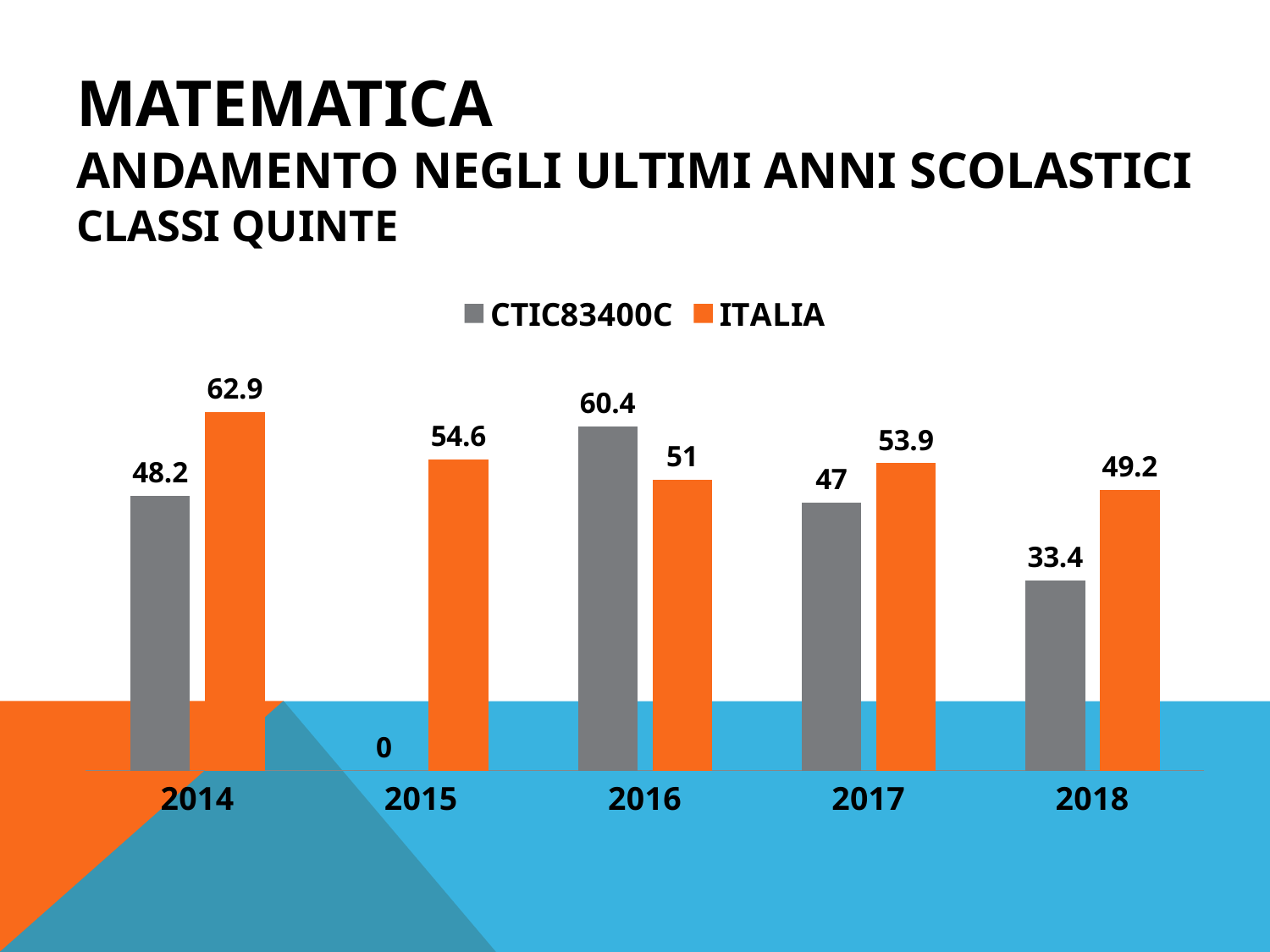
What is the value for CTIC83400C in 2014? 48.2 What kind of chart is shown on the slide? Bar chart In which year is the ITALIA value highest? 2014 Does the ITALIA value rise or fall from 2017 to 2018? Fall What is the difference between the ITALIA and CTIC83400C values in 2018? 15.8 What is the value for ITALIA in 2017? 53.9 What is the value for CTIC83400C in 2018? 33.4 How many series does the legend list? 2 In which year is the CTIC83400C value lowest (excluding the 0 in 2015)? 2018 What is the value for ITALIA in 2016? 51 Which is larger in 2016, CTIC83400C or ITALIA? CTIC83400C How many years are shown on the x axis? 5